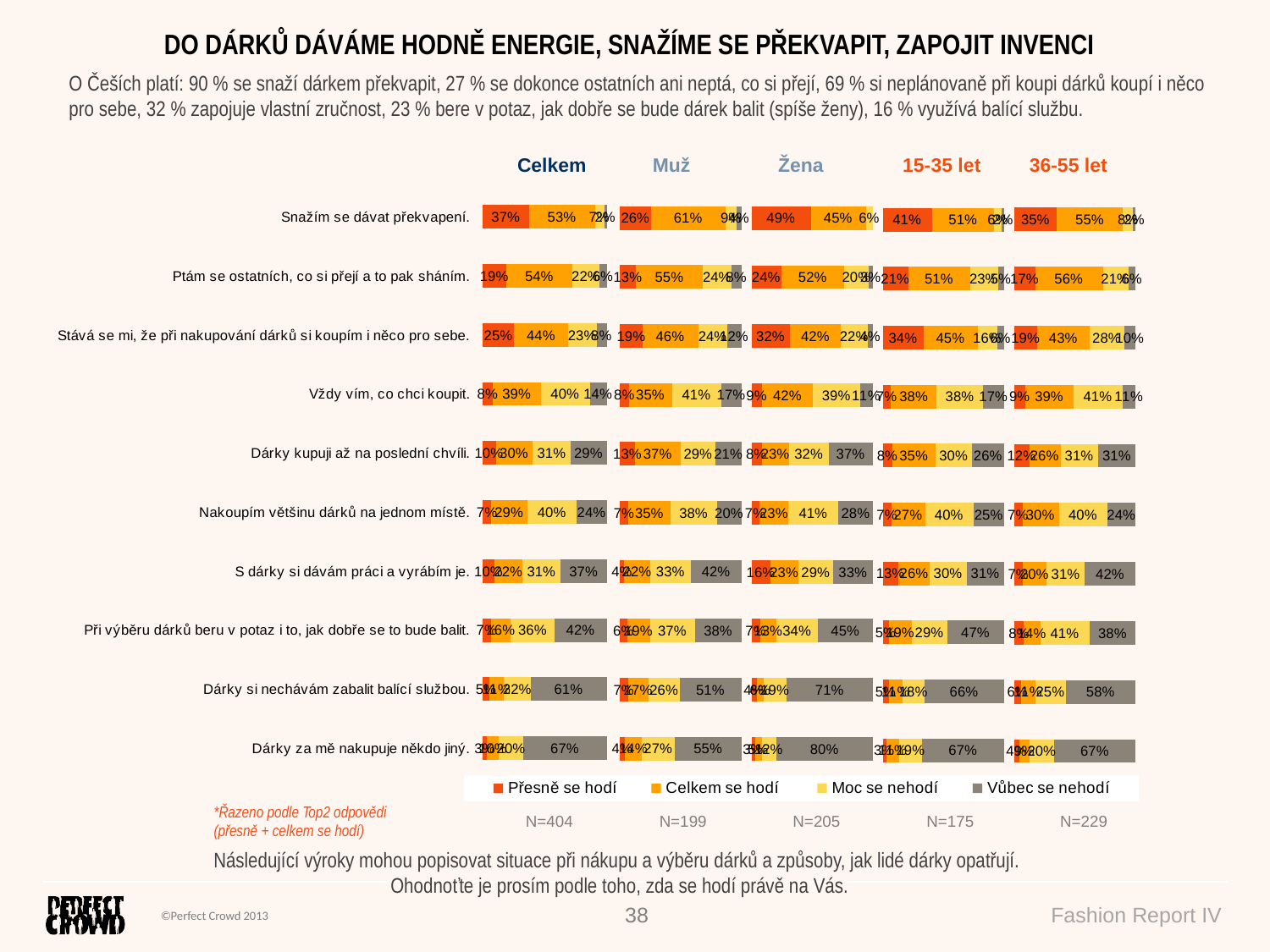
In the Žena chart, what is the value of "Přesně se hodí" for "Snažím se dávat překvapení."? 49% In the Muž chart, what is the value of "Celkem se hodí" for "Snažím se dávat překvapení."? 61% What kind of chart is used on this slide? Stacked bar chart In the Celkem chart, what is the value of "Vůbec se nehodí" for "Dárky si nechávám zabalit balící službou."? 61% Which is larger: the "Přesně se hodí" value for "Snažím se dávat překvapení." in the Muž chart or in the Žena chart? Žena What is the difference between the "Vůbec se nehodí" values for "Dárky za mě nakupuje někdo jiný." in the Žena chart and the Muž chart? 25% In the 15-35 let chart, what is the value of "Moc se nehodí" for "Při výběru dárků beru v potaz i to, jak dobře se to bude balit."? 29% What is the sample size (N) shown under the Celkem chart? N=404 In the Žena chart, what is the value of "Vůbec se nehodí" for "Dárky za mě nakupuje někdo jiný."? 80% How many series does the legend list? 4 In the Celkem chart, what is the value of "Přesně se hodí" for "Snažím se dávat překvapení."? 37% How many statements (categories) are plotted in each chart? 10